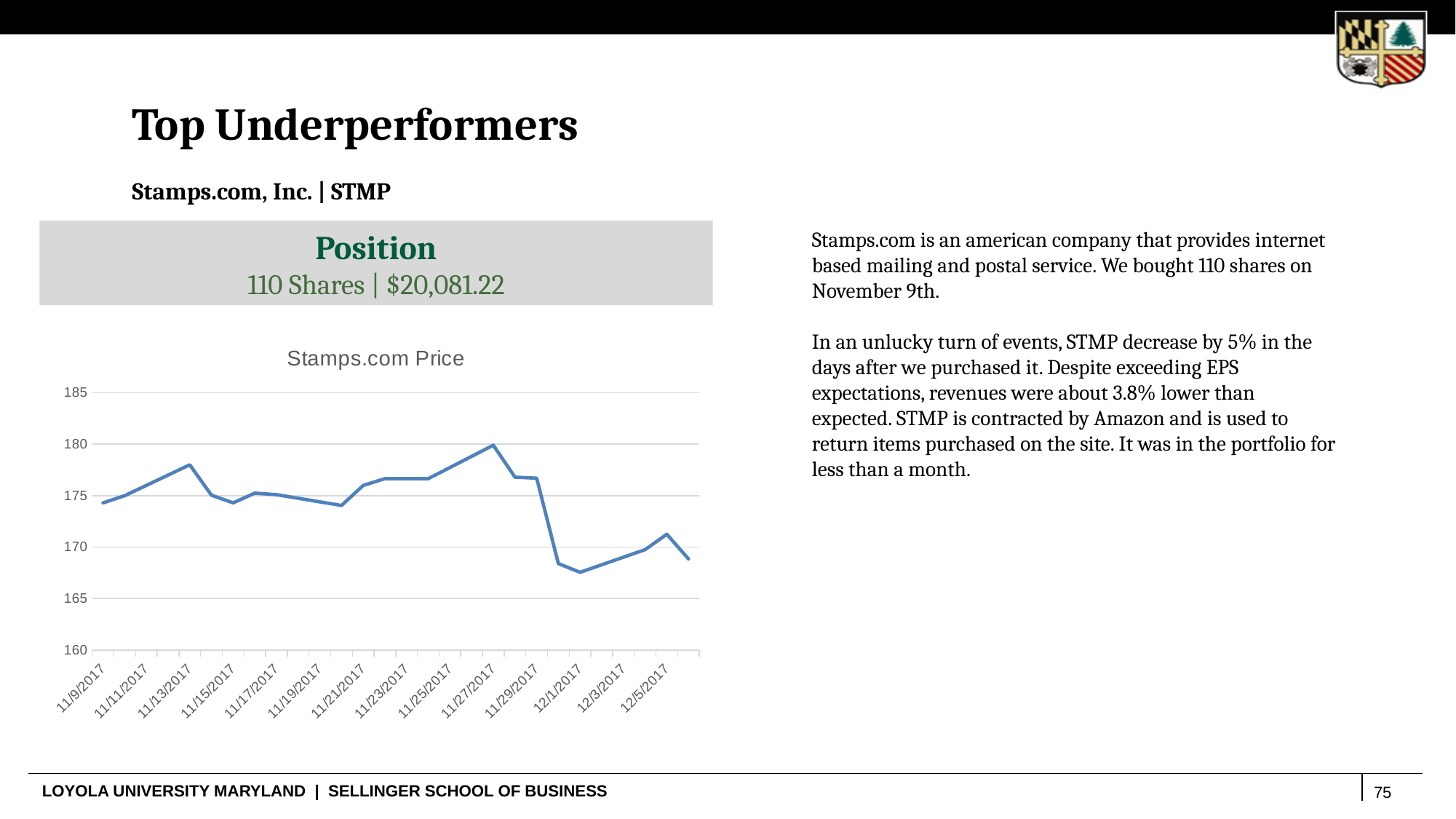
Which date has the higher Stamps.com price, 11/27/2017 or 12/1/2017? 11/27/2017 Is the Stamps.com price on 11/13/2017 greater or less than 175? greater Is the Stamps.com price on 11/29/2017 greater or less than 175? greater What kind of chart is shown on the slide? line chart What is the title of the chart? Stamps.com Price Is the Stamps.com price on 11/9/2017 greater or less than 175? less Overall, does the Stamps.com price rise or fall from the start to the end of the chart? fall Which date has the higher Stamps.com price, 11/13/2017 or 11/21/2017? 11/13/2017 On which labeled date does the Stamps.com price reach its lowest point? 12/1/2017 On which labeled date does the Stamps.com price reach its highest point? 11/27/2017 What is the highest value shown on the chart's vertical axis? 185